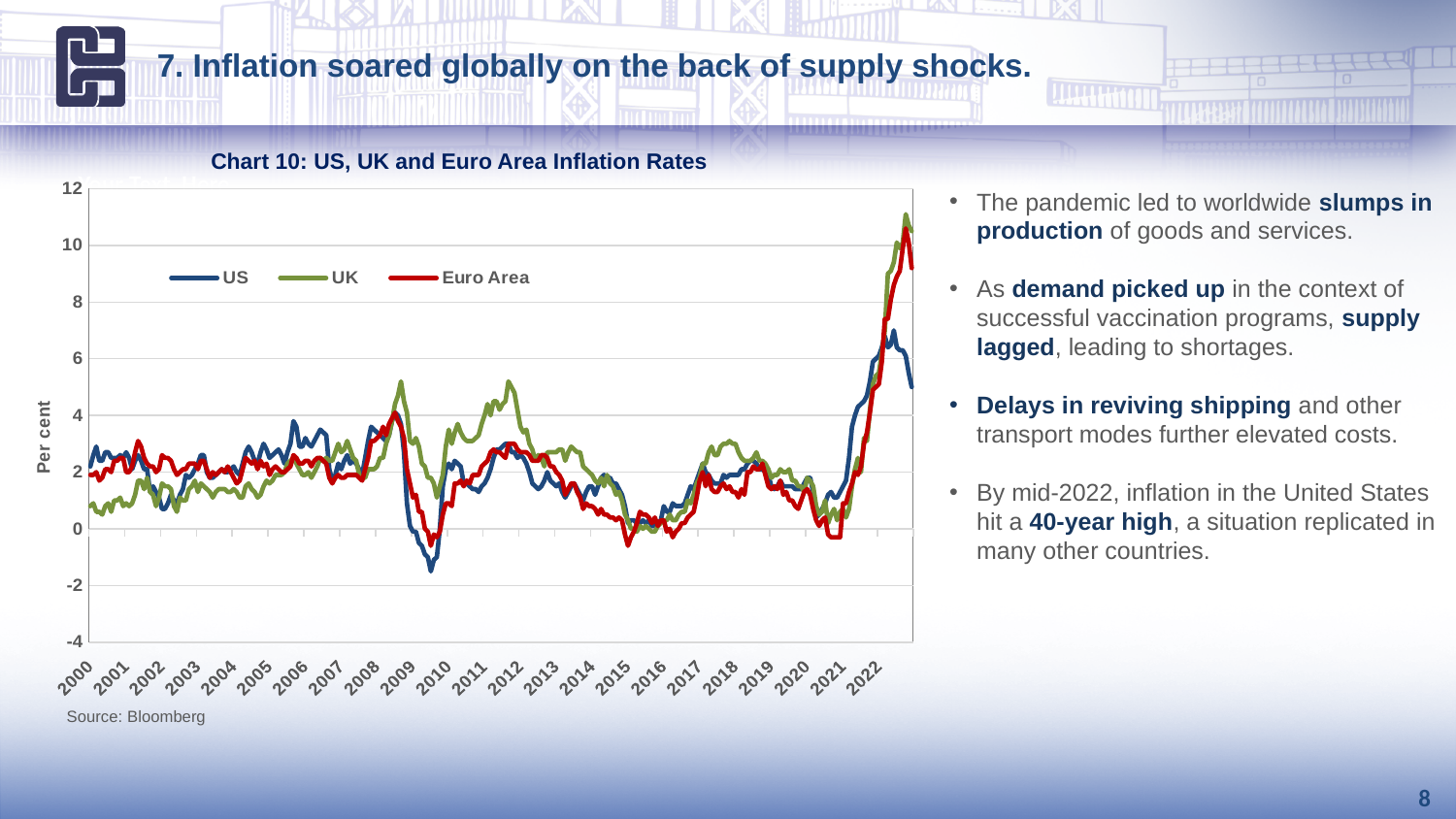
What kind of chart is Chart 10? line chart Do the inflation rates in Chart 10 rise or fall between 2021 and 2022? rise What is the label on the vertical axis of Chart 10? Per cent Which series are shown in Chart 10? US, UK, Euro Area Is the lowest value of the US series, around 2009, greater or less than 0? less Is the peak value of the US series in 2022 greater or less than 6? greater Which series reaches the lowest value anywhere on Chart 10? US Is the UK value at the start of 2000 greater or less than 2? less In 2022, which series reaches a higher peak, the UK or the US? UK How many series does the legend of Chart 10 list? 3